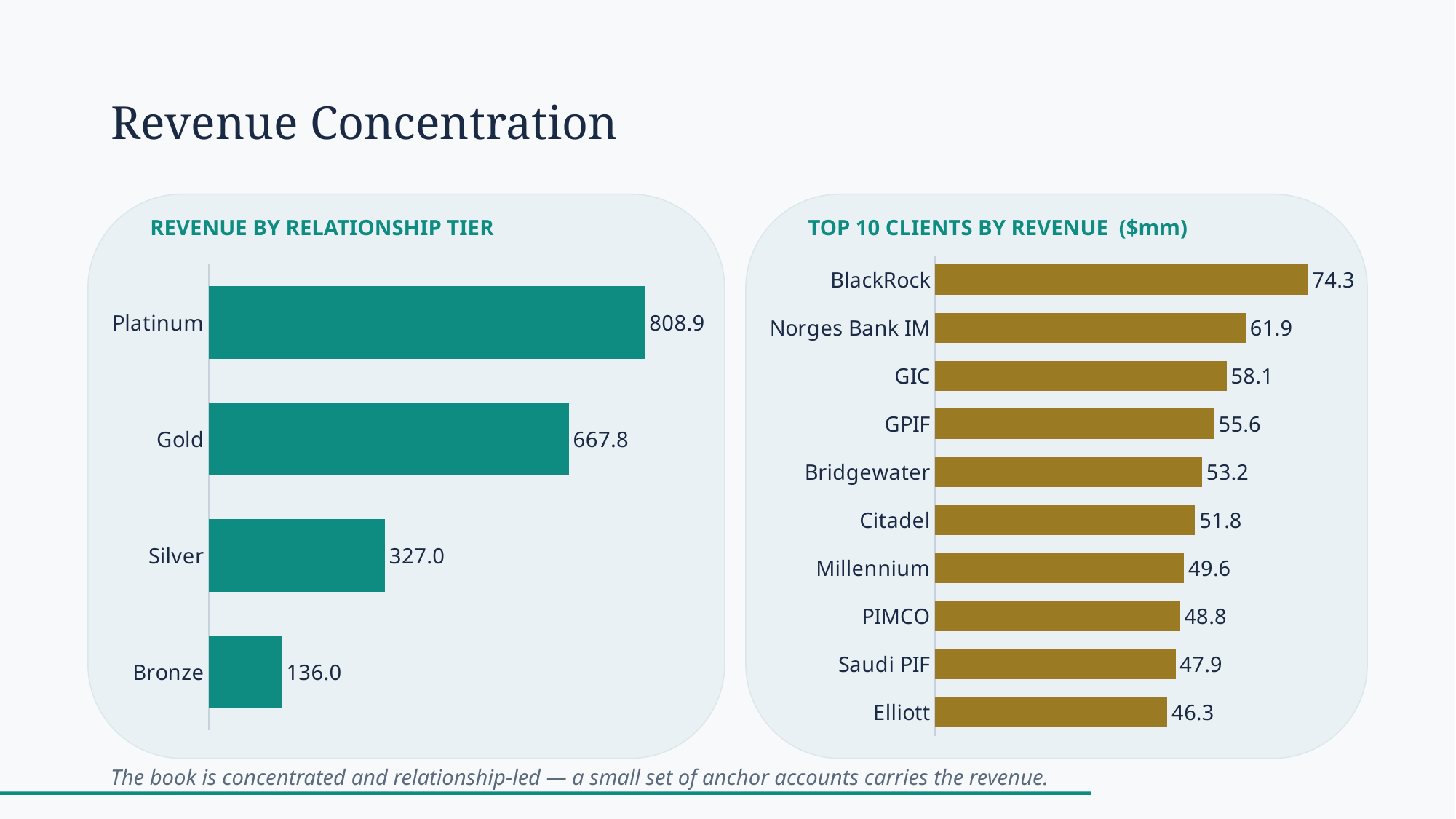
In the 'Top 10 Clients by Revenue' chart, which client has the lowest revenue? Elliott In the 'Top 10 Clients by Revenue' chart, what is the value for Citadel? 51.8 In the 'Top 10 Clients by Revenue' chart, which is larger, GIC or Bridgewater? GIC In the 'Top 10 Clients by Revenue' chart, how many clients are shown? 10 In the 'Revenue by Relationship Tier' chart, which tier has the lowest revenue? Bronze In the 'Revenue by Relationship Tier' chart, what is the value for Gold? 667.8 In the 'Top 10 Clients by Revenue' chart, which client has the highest revenue? BlackRock In the 'Revenue by Relationship Tier' chart, what is the difference between Platinum and Gold? 141.1 What kind of chart is the 'Revenue by Relationship Tier' chart? Bar chart In the 'Revenue by Relationship Tier' chart, how many tiers are shown? 4 In the 'Top 10 Clients by Revenue' chart, what is the difference between BlackRock and Norges Bank IM? 12.4 What unit is given in the title of the 'Top 10 Clients by Revenue' chart? $mm